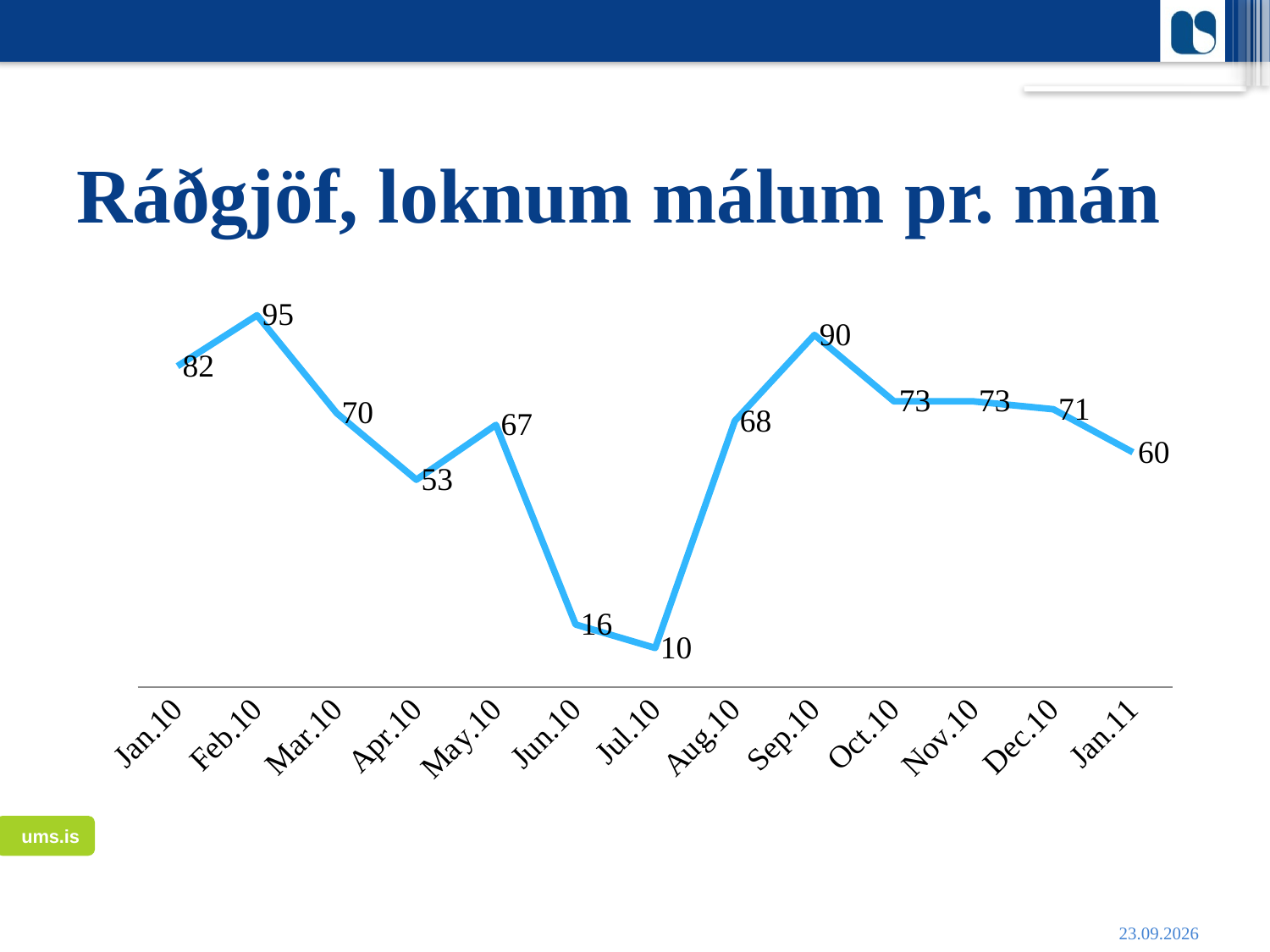
What is the value for Feb.10? 95 What is the difference between the values for Feb.10 and Jul.10? 85 Do the values rise or fall from Sep.10 to Jan.11? fall What is the value for Jan.11? 60 How many months are plotted on the chart? 13 What is the difference between the values for Sep.10 and Aug.10? 22 What is the value for Jul.10? 10 Which is larger, the value for Mar.10 or the value for May.10? Mar.10 Which month has the lowest value? Jul.10 What is the value for Sep.10? 90 Which month has the highest value? Feb.10 What kind of chart is shown on the slide? line chart